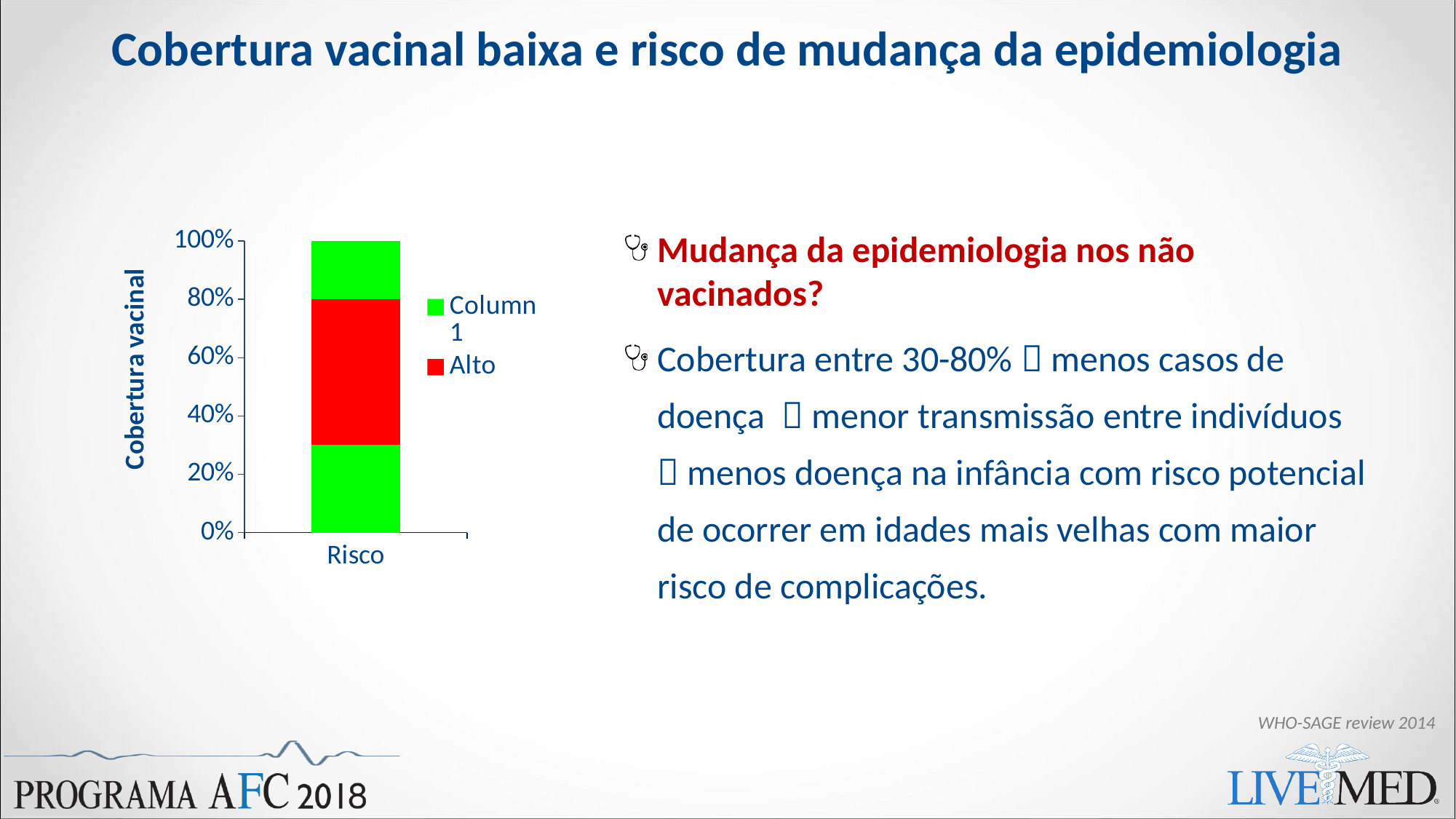
What is the label of the single category on the x axis? Risco Is the bottom of the red 'Alto' segment greater or less than 40%? less What is the total height of the stacked bar for Risco, as read from the y axis? 100% Is the top of the red 'Alto' segment greater or less than 60%? greater How many categories are shown on the x axis of the chart? 1 What is the title of the y axis of the chart? Cobertura vacinal What kind of chart is shown on the slide? Stacked bar chart Does the top of the red 'Alto' segment land above or below the 100% line? below How many series does the chart legend list? 2